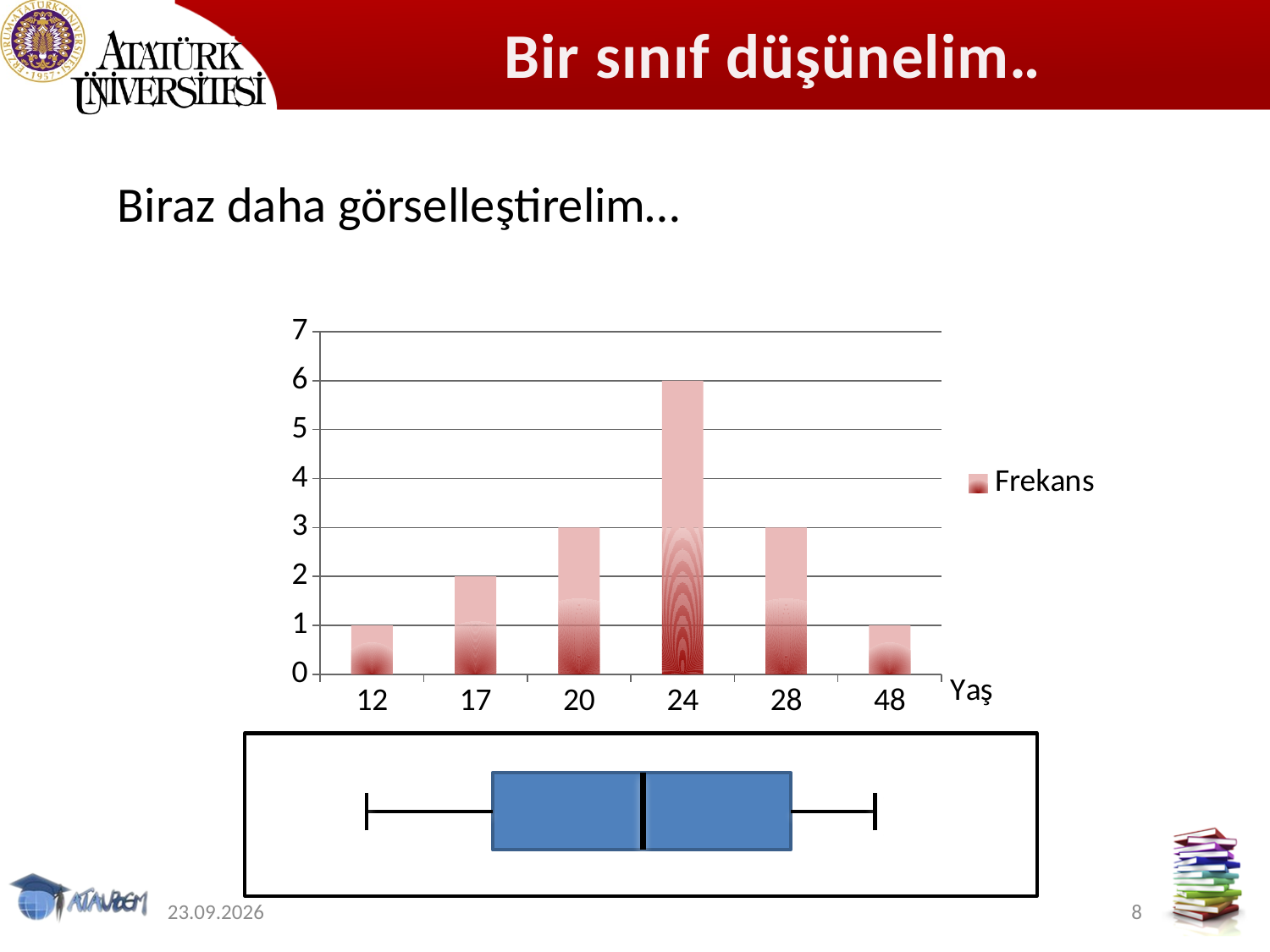
In the bar chart, what is the Frekans value for age 48? 1 In the bar chart, what is the difference between the Frekans values for ages 24 and 20? 3 How many age categories are shown on the x axis of the bar chart? 6 In the bar chart, is the Frekans value for age 24 greater or less than 5? greater In the bar chart, which age has the highest Frekans? 24 How many series does the legend of the bar chart list? 1 In the bar chart, what is the Frekans value for age 24? 6 In the bar chart, which has a larger Frekans value: age 17 or age 28? 28 What kind of chart is the upper chart on the slide? bar chart In the bar chart, what is the Frekans value for age 17? 2 In the bar chart, do the Frekans values rise or fall from age 12 to age 24? rise What is the label of the x axis of the bar chart? Yaş